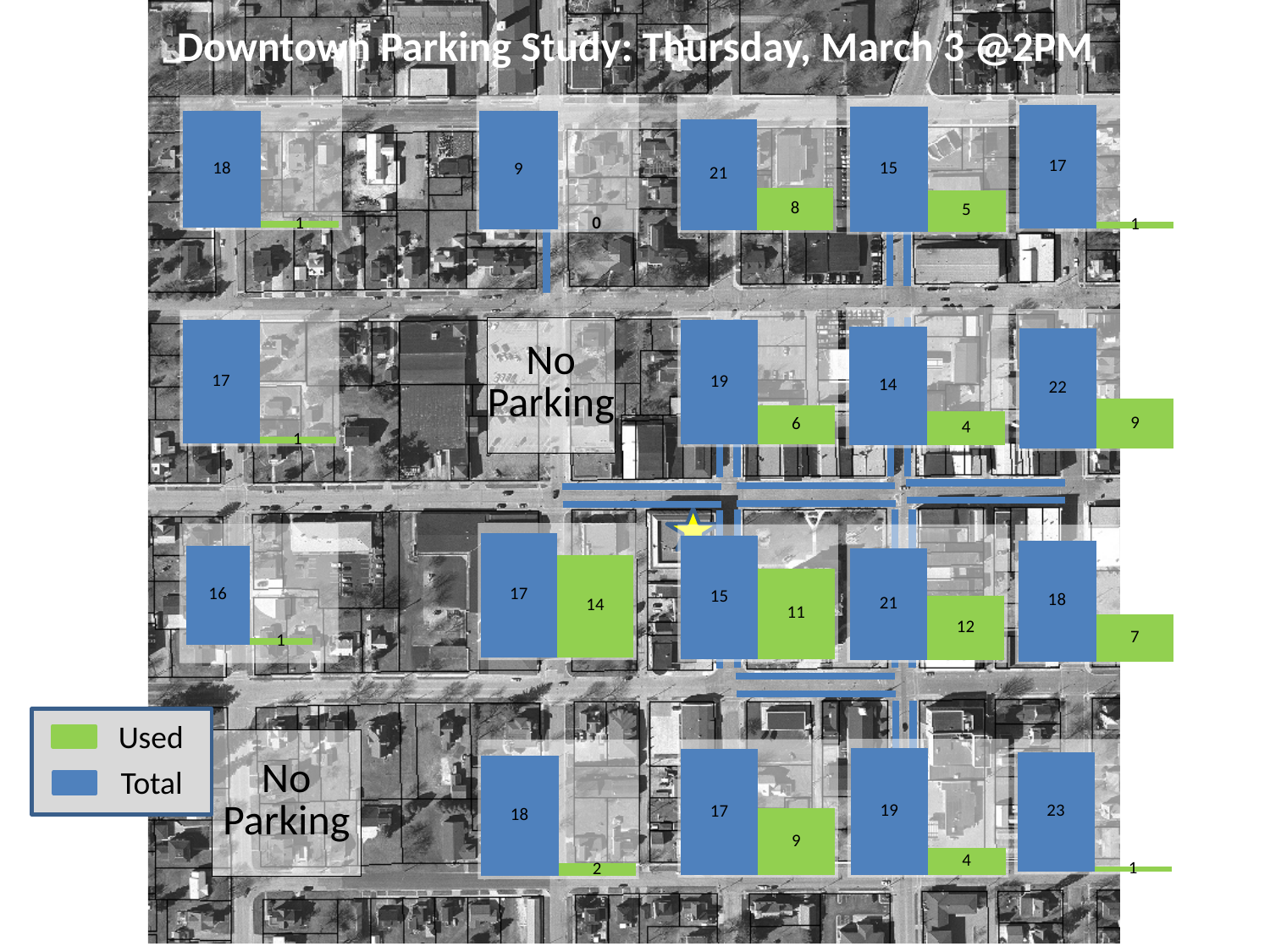
What does the green colour represent according to the legend? Used For the block in the top row, second from the left, what is the Used value? 0 For the rightmost block in the second row, what is the Used value? 9 What kind of chart is used on each block of the map? bar chart For the block in the top-left corner of the map, what is the Total value? 18 For the block in the bottom-right corner of the map, what is the Used value? 1 What is the highest Used value shown on any block? 14 How many series does the legend list? 2 For the block in the bottom-right corner of the map, what is the difference between Total and Used? 22 What is the highest Total value shown on any block? 23 For the block in the third row, second from the left, which is larger: Total or Used? Total What is the title of the slide? Downtown Parking Study: Thursday, March 3 @2PM